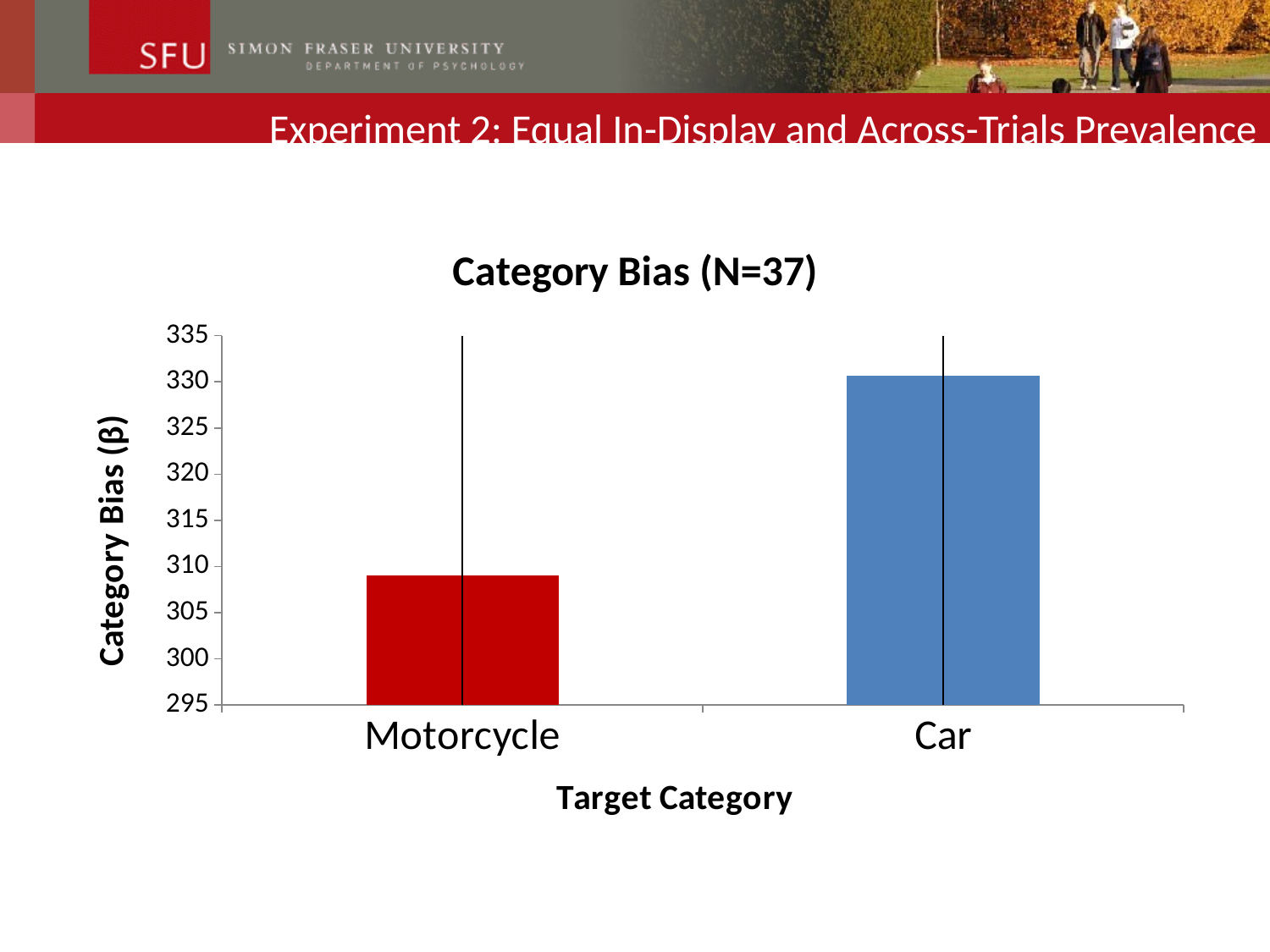
How many categories are shown on the x axis of the chart? 2 What type of chart is shown on the slide? bar chart What is the label of the y axis? Category Bias (β) Which has a larger category bias, Motorcycle or Car? Car What is the title of the chart? Category Bias (N=37) Do the values rise or fall from Motorcycle to Car along the x axis? rise Is the category bias for Motorcycle greater or less than 310? less Is the category bias for Motorcycle greater or less than 305? greater Which target category has the highest category bias? Car Is the category bias for Car greater or less than 335? less Which target category has the lowest category bias? Motorcycle